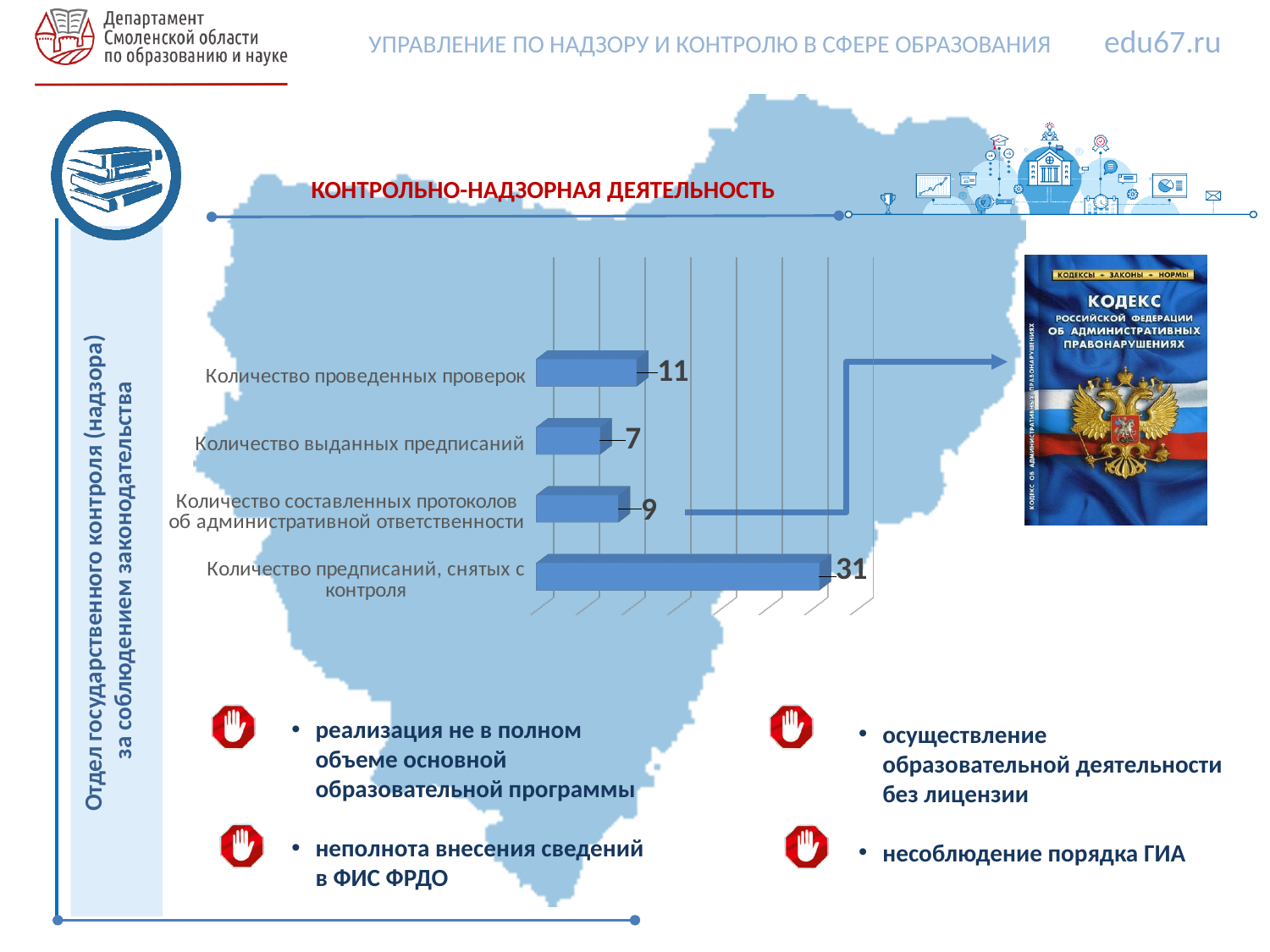
What is the value for "Количество составленных протоколов об административной ответственности"? 9 What is the value for "Количество проведенных проверок"? 11 What kind of chart is shown on the slide? Bar chart What is the value for "Количество выданных предписаний"? 7 What is the value for "Количество предписаний, снятых с контроля"? 31 Which category has the lowest value? Количество выданных предписаний What is the difference between the value for "Количество предписаний, снятых с контроля" and the value for "Количество проведенных проверок"? 20 What is the difference between the value for "Количество проведенных проверок" and the value for "Количество выданных предписаний"? 4 What colour are the bars in the chart? Blue Which is larger: the value for "Количество составленных протоколов об административной ответственности" or the value for "Количество выданных предписаний"? Количество составленных протоколов об административной ответственности Which category has the highest value? Количество предписаний, снятых с контроля How many categories are shown in the chart? 4